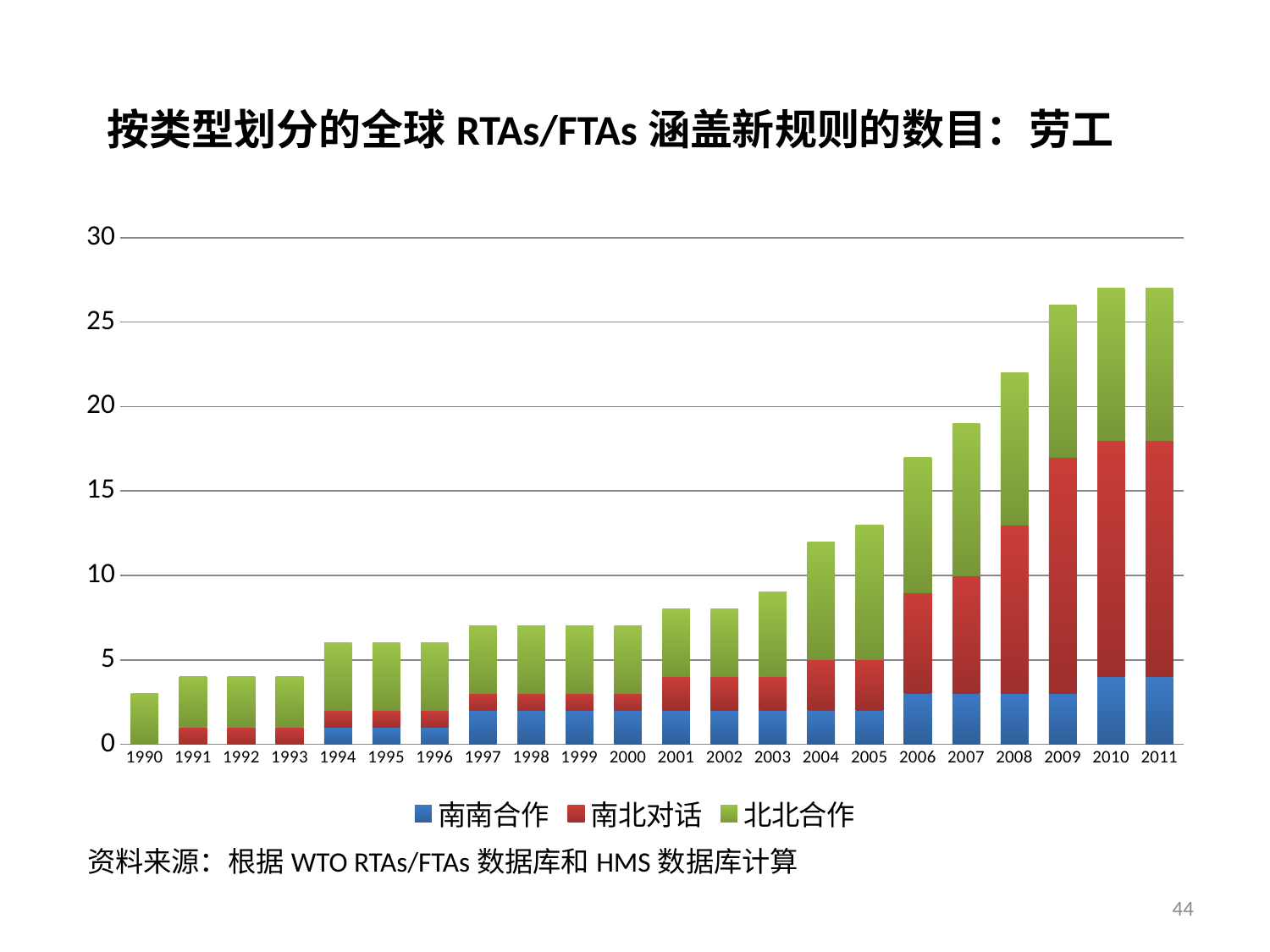
Is the total value for 2011 greater or less than 25? greater Is the total value for 2006 greater or less than 15? greater What kind of chart is shown on the slide? bar chart Do the total values generally rise or fall from 1990 to 2011? rise Which year has the larger total bar, 2004 or 2008? 2008 Which year has the lowest total bar? 1990 Is the total value for 2008 greater or less than 20? greater Which series is shown in blue in the legend? 南南合作 How many years are shown along the x axis? 22 How many series does the legend list? 3